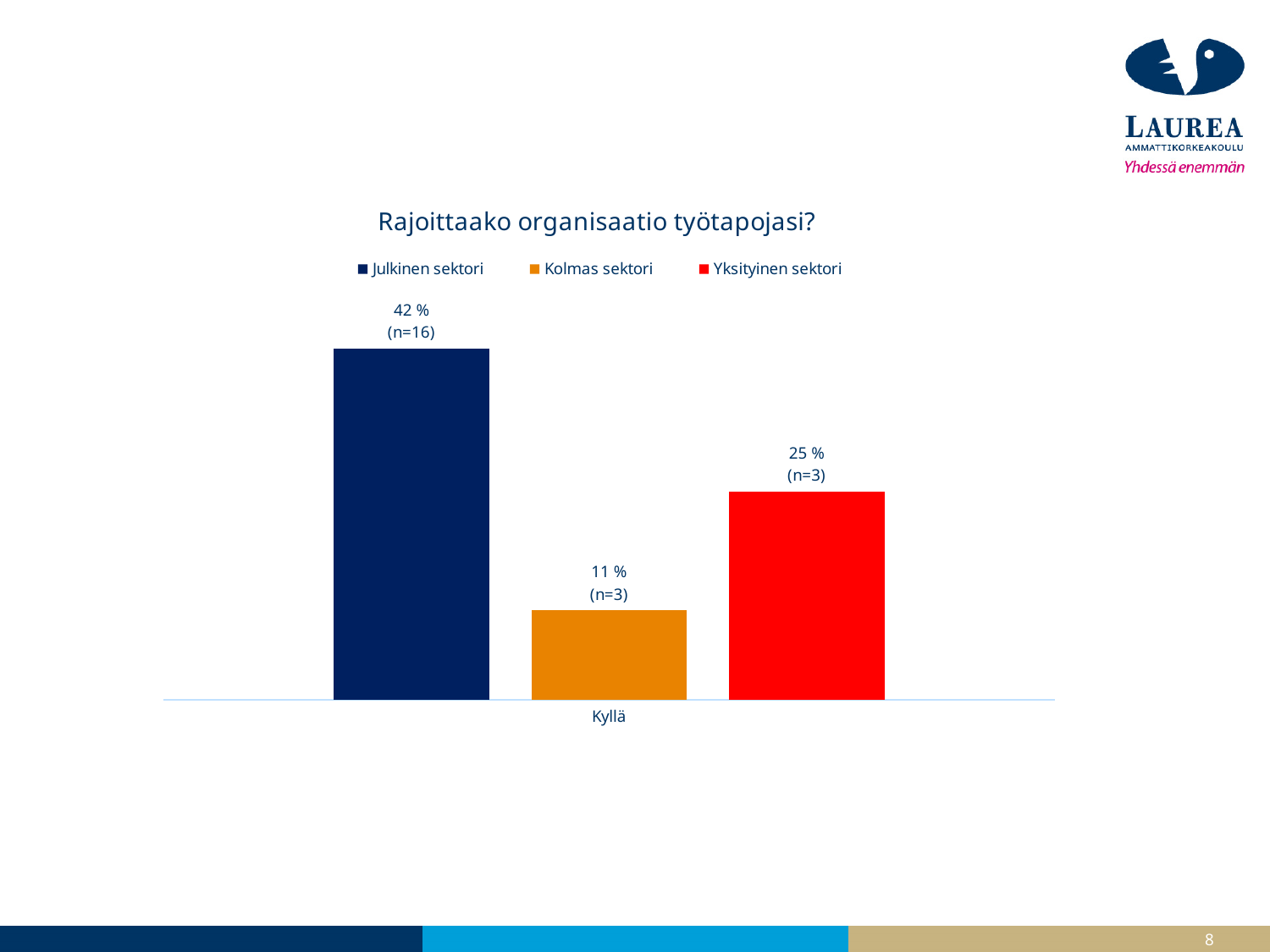
How many series does the legend list? 3 What is the value for Julkinen sektori in the Kyllä category? 42 % What is the value for Yksityinen sektori in the Kyllä category? 25 % Which series has the lowest value? Kolmas sektori What is the difference in percentage points between Julkinen sektori and Yksityinen sektori? 17 What is the value for Kolmas sektori in the Kyllä category? 11 % Which series has the highest value? Julkinen sektori Which is larger, the value for Kolmas sektori or the value for Yksityinen sektori? Yksityinen sektori What kind of chart is shown on the slide? Bar chart What is the n value shown for Julkinen sektori? n=16 What is the title of the chart? Rajoittaako organisaatio työtapojasi? What is the difference in percentage points between Yksityinen sektori and Kolmas sektori? 14